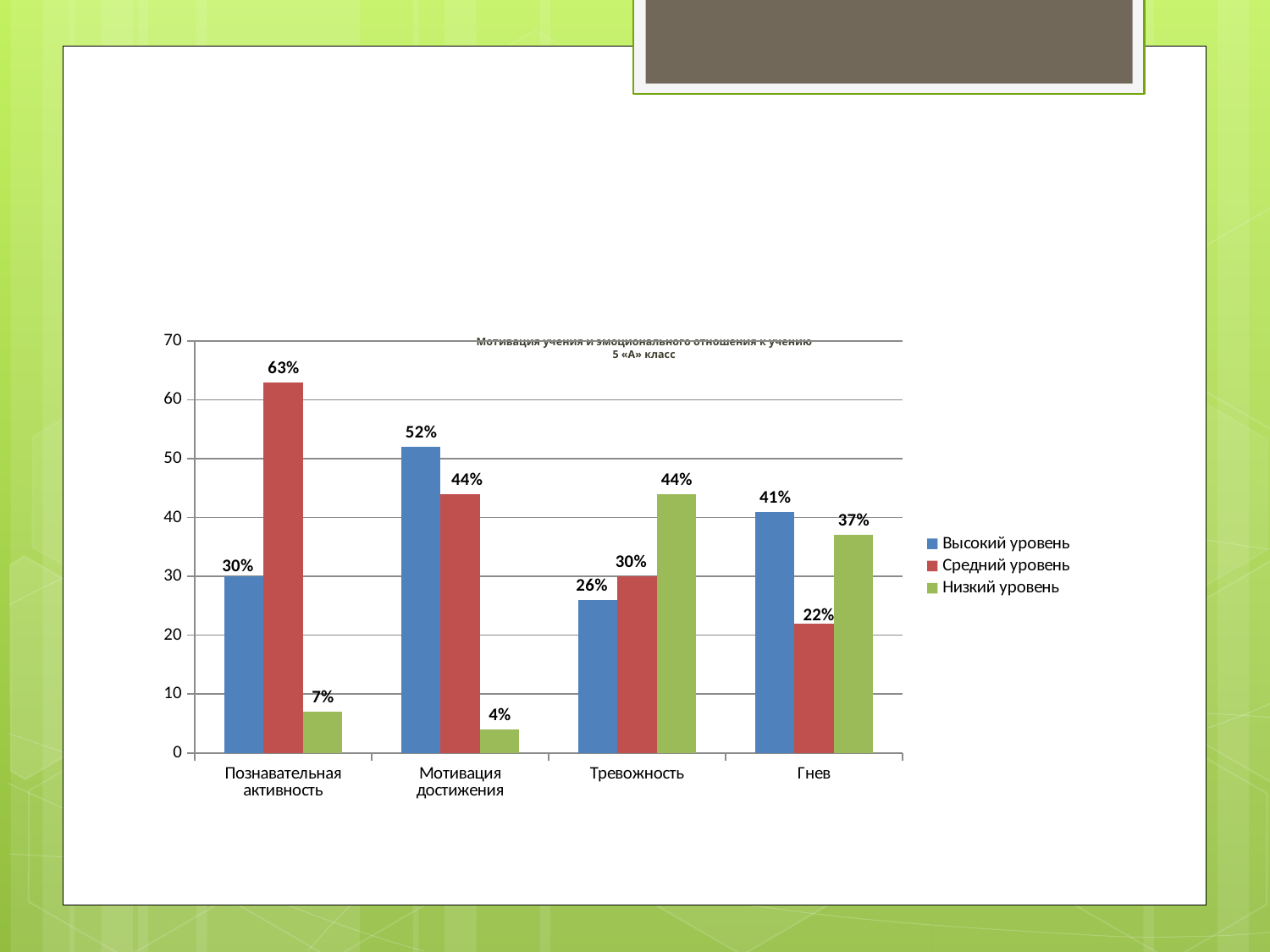
Which category has the lowest value for Высокий уровень? Тревожность Is the value of Высокий уровень for Мотивация достижения greater or less than 50? greater What is the difference between Средний уровень and Низкий уровень for Познавательная активность? 56% How many series does the legend list? 3 What is the value of Низкий уровень for Мотивация достижения? 4% Which legend entry is shown in green? Низкий уровень Which is larger for Гнев: Низкий уровень or Средний уровень? Низкий уровень What kind of chart is shown on the slide? Bar chart How many categories are shown on the x axis? 4 What is the value of Высокий уровень for Гнев? 41% Which category has the highest value for Низкий уровень? Тревожность What is the value of Средний уровень for Познавательная активность? 63%